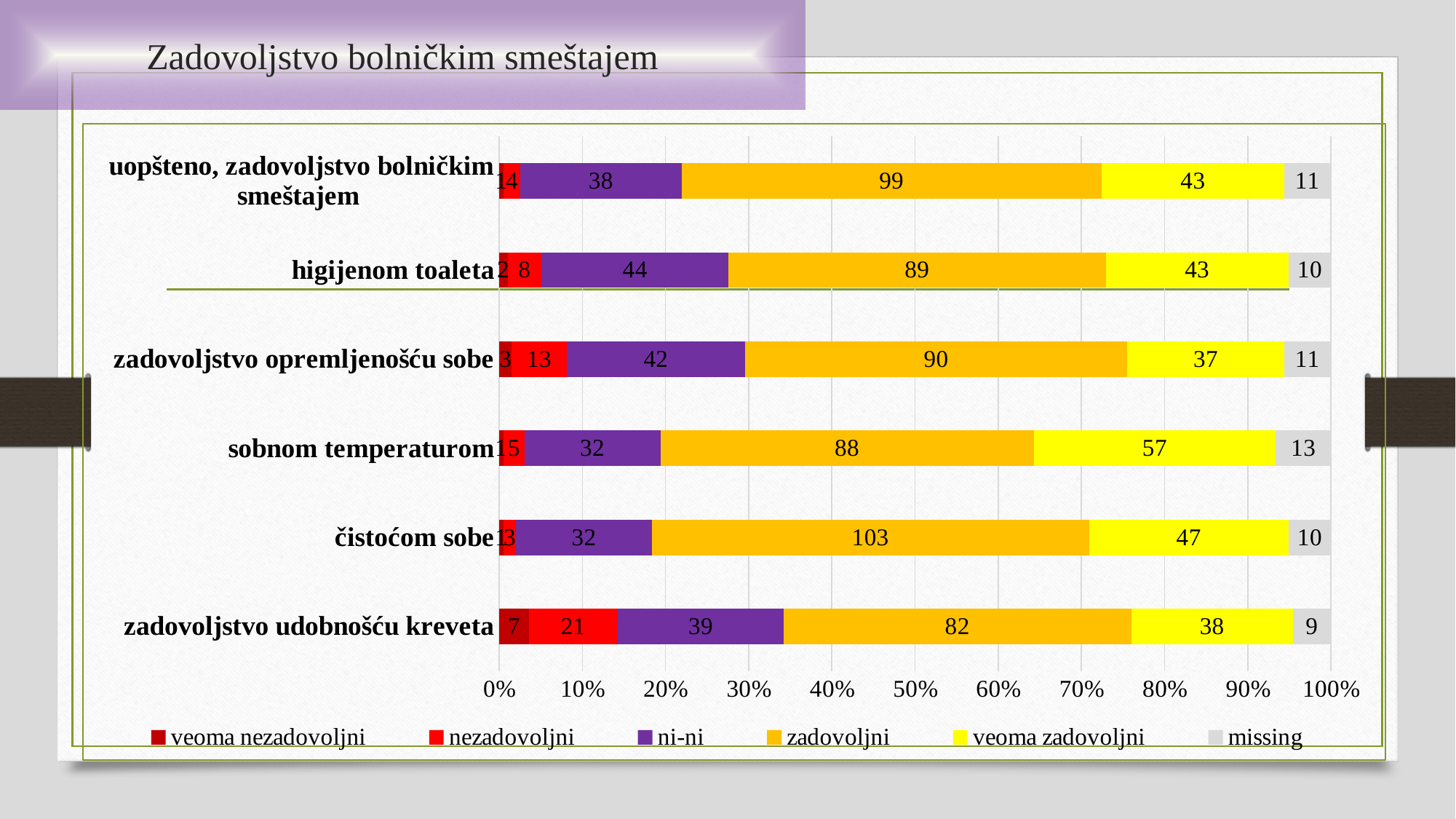
How many series does the legend list? 6 What kind of chart is shown on the slide? stacked bar chart How many categories (rows) does the chart show? 6 What is the value of 'veoma zadovoljni' for 'sobnom temperaturom'? 57 Which category has the highest 'zadovoljni' value? čistoćom sobe What is the value of 'missing' for 'sobnom temperaturom'? 13 What is the value of 'zadovoljni' for 'čistoćom sobe'? 103 What is the total of all segments in the 'higijenom toaleta' bar? 196 What is the value of 'nezadovoljni' for 'zadovoljstvo udobnošću kreveta'? 21 Which has the larger 'ni-ni' value: 'higijenom toaleta' or 'zadovoljstvo opremljenošću sobe'? higijenom toaleta What is the difference between the 'veoma zadovoljni' values for 'sobnom temperaturom' and 'zadovoljstvo udobnošću kreveta'? 19 Which category has the lowest 'zadovoljni' value? zadovoljstvo udobnošću kreveta